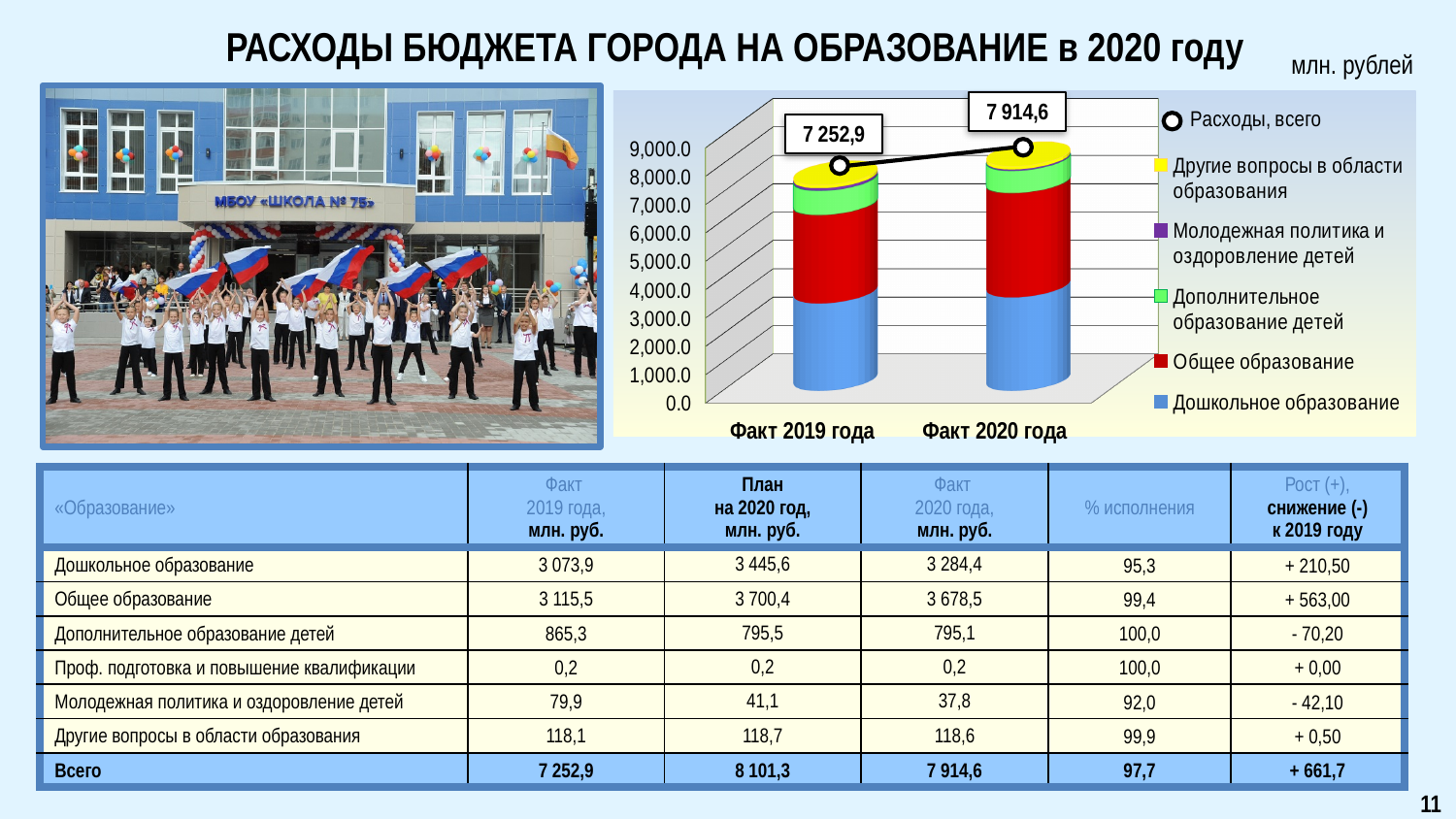
How many categories are shown on the x axis of the chart? 2 By how much does «Расходы, всего» for «Факт 2020 года» exceed that for «Факт 2019 года»? 661,7 What is the value of «Расходы, всего» for «Факт 2020 года»? 7 914,6 Which category has the higher total expenditure, «Факт 2019 года» or «Факт 2020 года»? Факт 2020 года Do total expenditures rise or fall from «Факт 2019 года» to «Факт 2020 года»? Rise What is the title of the chart on the slide? РАСХОДЫ БЮДЖЕТА ГОРОДА НА ОБРАЗОВАНИЕ в 2020 году What kind of chart is shown on the slide? Stacked bar chart with a line Is the value of «Расходы, всего» for «Факт 2019 года» greater or less than 7,000.0? greater What is the value of «Расходы, всего» for «Факт 2019 года»? 7 252,9 Which category has the highest total expenditure? Факт 2020 года Which legend entry is shown in yellow? Другие вопросы в области образования How many entries does the chart legend list? 6